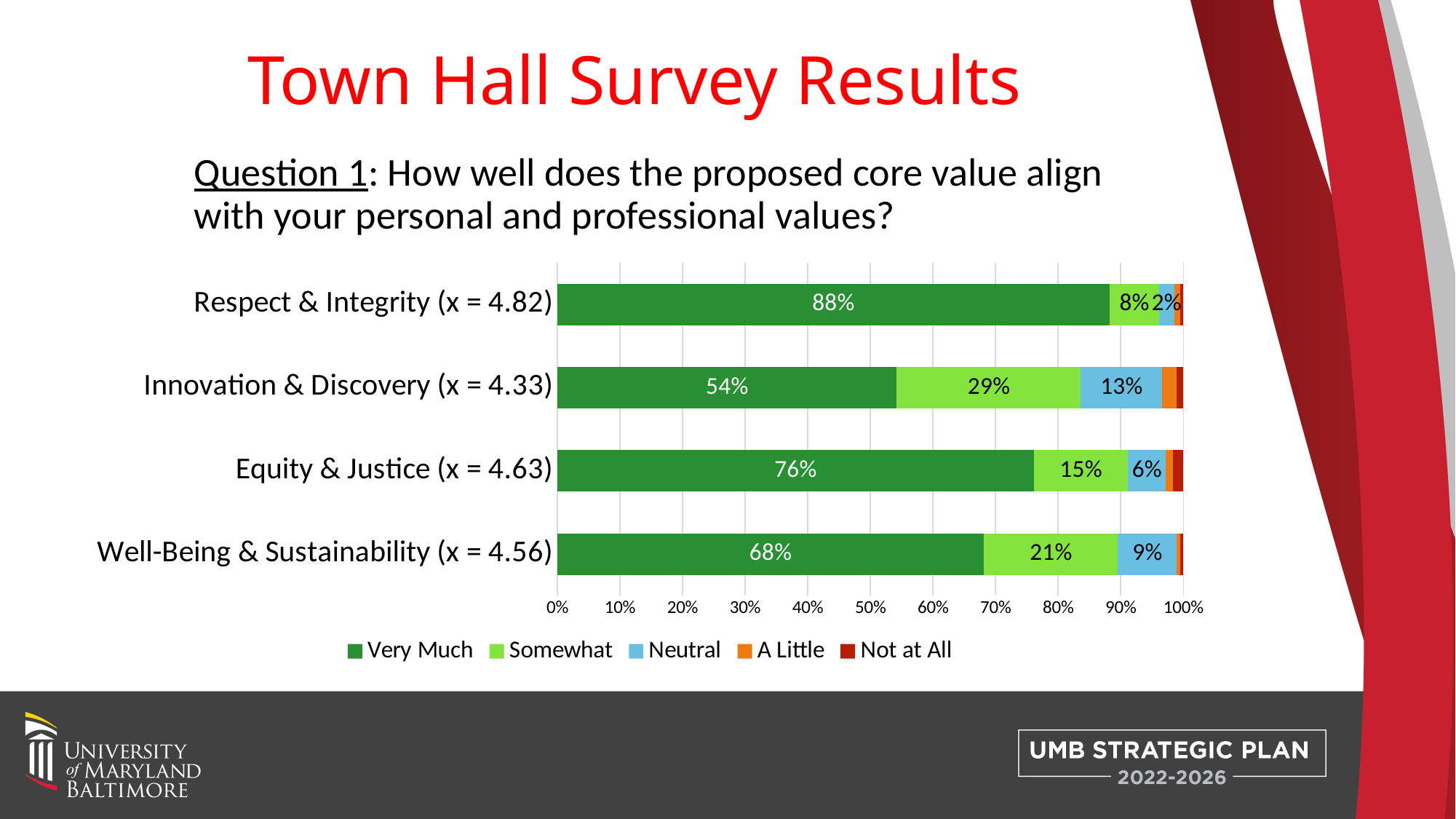
What is the difference between the "Very Much" percentages for Equity & Justice and Well-Being & Sustainability? 8% Which core value has the lowest "Very Much" percentage? Innovation & Discovery How many core values (categories) are plotted in the chart? 4 What is the "Somewhat" percentage for Innovation & Discovery? 29% What is the "Very Much" percentage for Respect & Integrity? 88% Which has a larger "Neutral" percentage, Innovation & Discovery or Equity & Justice? Innovation & Discovery How many series does the legend list? 5 What is the "Neutral" percentage for Well-Being & Sustainability? 9% What is the "Somewhat" percentage for Equity & Justice? 15% What kind of chart is shown on the slide? Stacked bar chart Which core value has the highest "Very Much" percentage? Respect & Integrity Which series is shown in dark green in the legend? Very Much